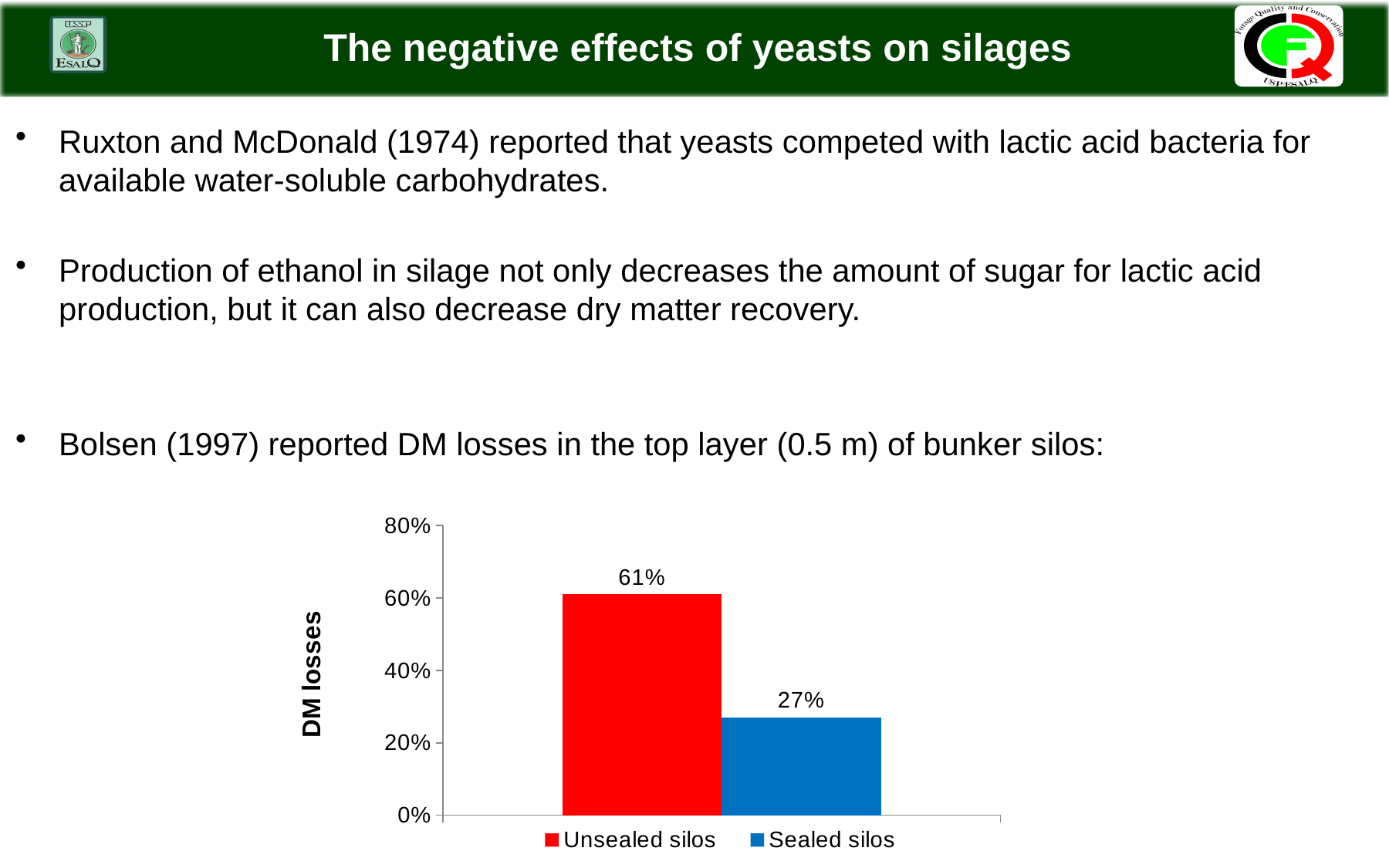
Is the DM loss value for unsealed silos greater or less than 60%? greater Which has larger DM losses, unsealed silos or sealed silos? Unsealed silos What is the difference in DM losses between unsealed silos and sealed silos? 34% Is the DM loss value for sealed silos greater or less than 40%? less Which series has the lowest DM losses? Sealed silos What is the label of the vertical axis of the chart? DM losses Which series has the highest DM losses? Unsealed silos What is the DM loss value for sealed silos? 27% What colour is the bar for sealed silos? Blue What is the DM loss value for unsealed silos? 61% How many series does the legend list? 2 What kind of chart is shown on the slide? Bar chart